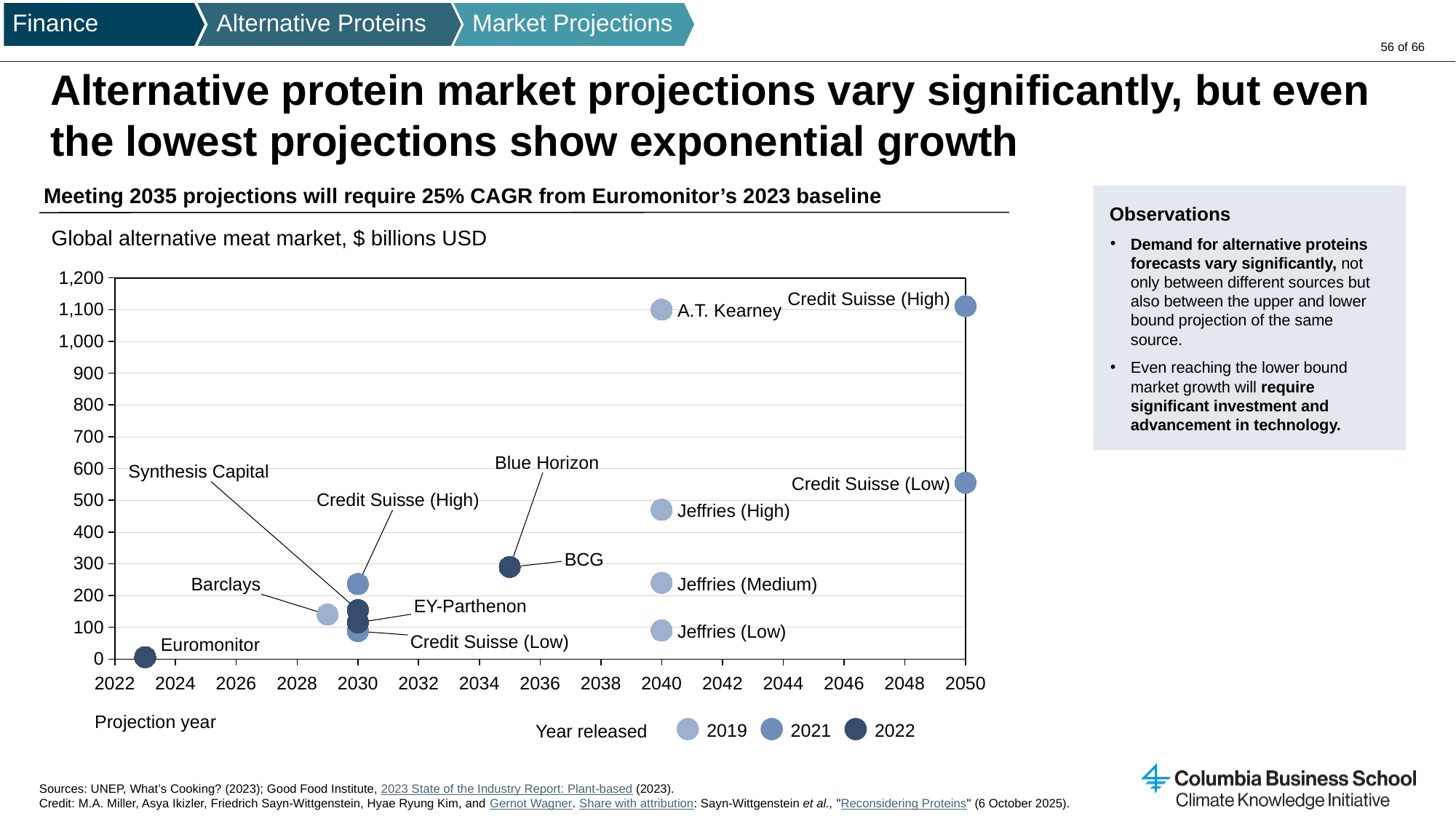
What kind of chart is shown on the slide? scatter chart Which is larger, Jeffries (High) or Jeffries (Medium)? Jeffries (High) Is the value for Jeffries (Low) greater or less than 200? less What is the projection year for Jeffries (High)? 2040 Is the value for Credit Suisse (Low) at 2050 greater or less than 500? greater How many release years does the legend list? 3 Is the value for A.T. Kearney greater or less than 1,000? greater Which is larger, Credit Suisse (High) at 2050 or Credit Suisse (Low) at 2050? Credit Suisse (High) What unit does the chart say the market values are in? $ billions USD Which source has the lowest market value on the chart? Euromonitor What is the projection year for A.T. Kearney? 2040